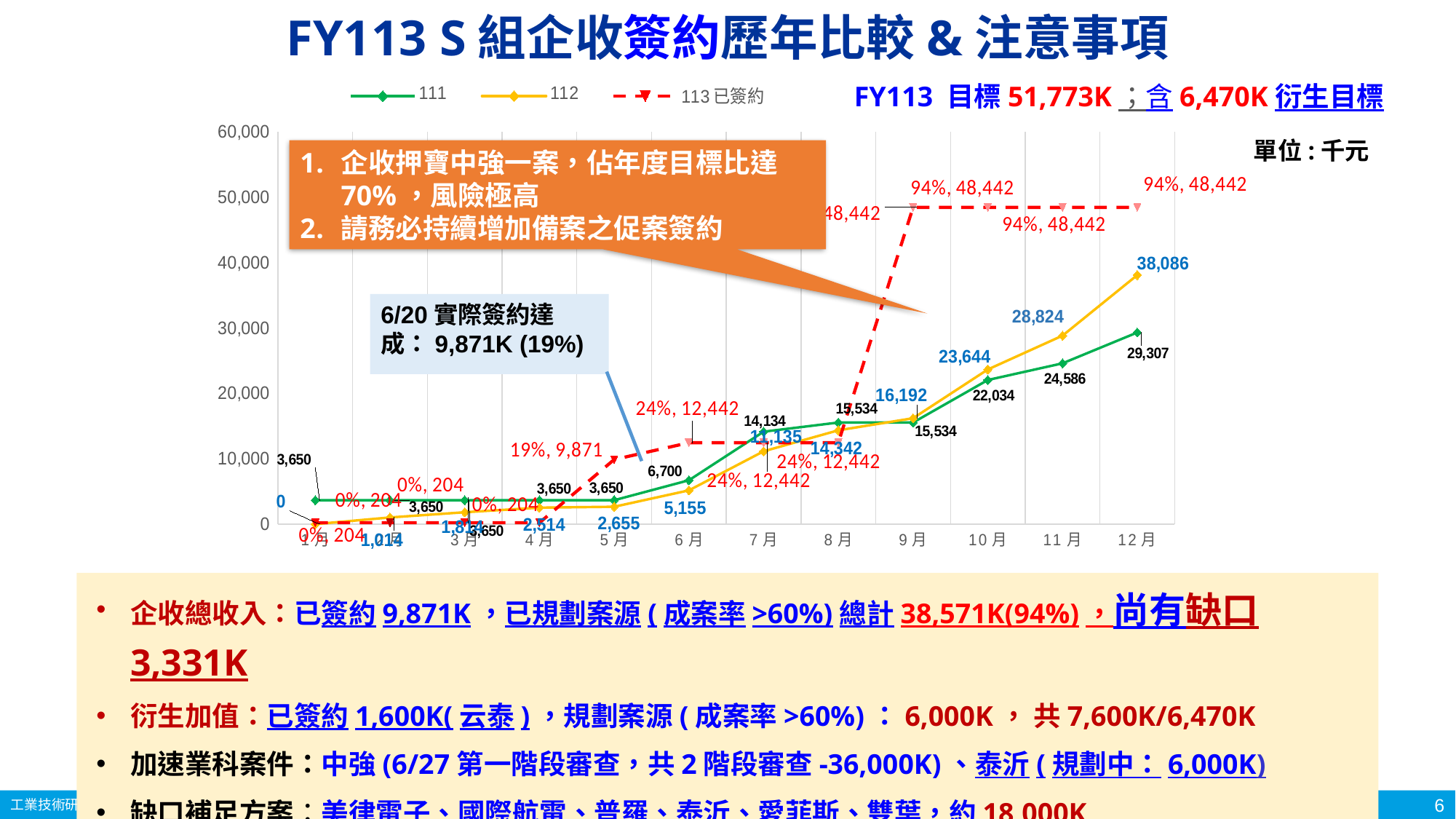
Is the value of series 113 已簽約 in 12月 greater or less than 40,000? greater What is the value of series 111 in 10月? 22,034 What is the value of series 112 in 12月? 38,086 How many months are shown along the x axis of the chart? 12 How many series does the chart legend list? 3 What unit is stated for the values in the chart? 千元 What is the value of series 112 in 11月? 28,824 What is the difference between series 112 and series 111 in 12月? 8,779 What is the value of series 111 in 12月? 29,307 In 12月, which series has the larger value, 111 or 112? 112 What kind of chart is shown on the slide? line chart In which month does series 112 reach its highest value? 12月